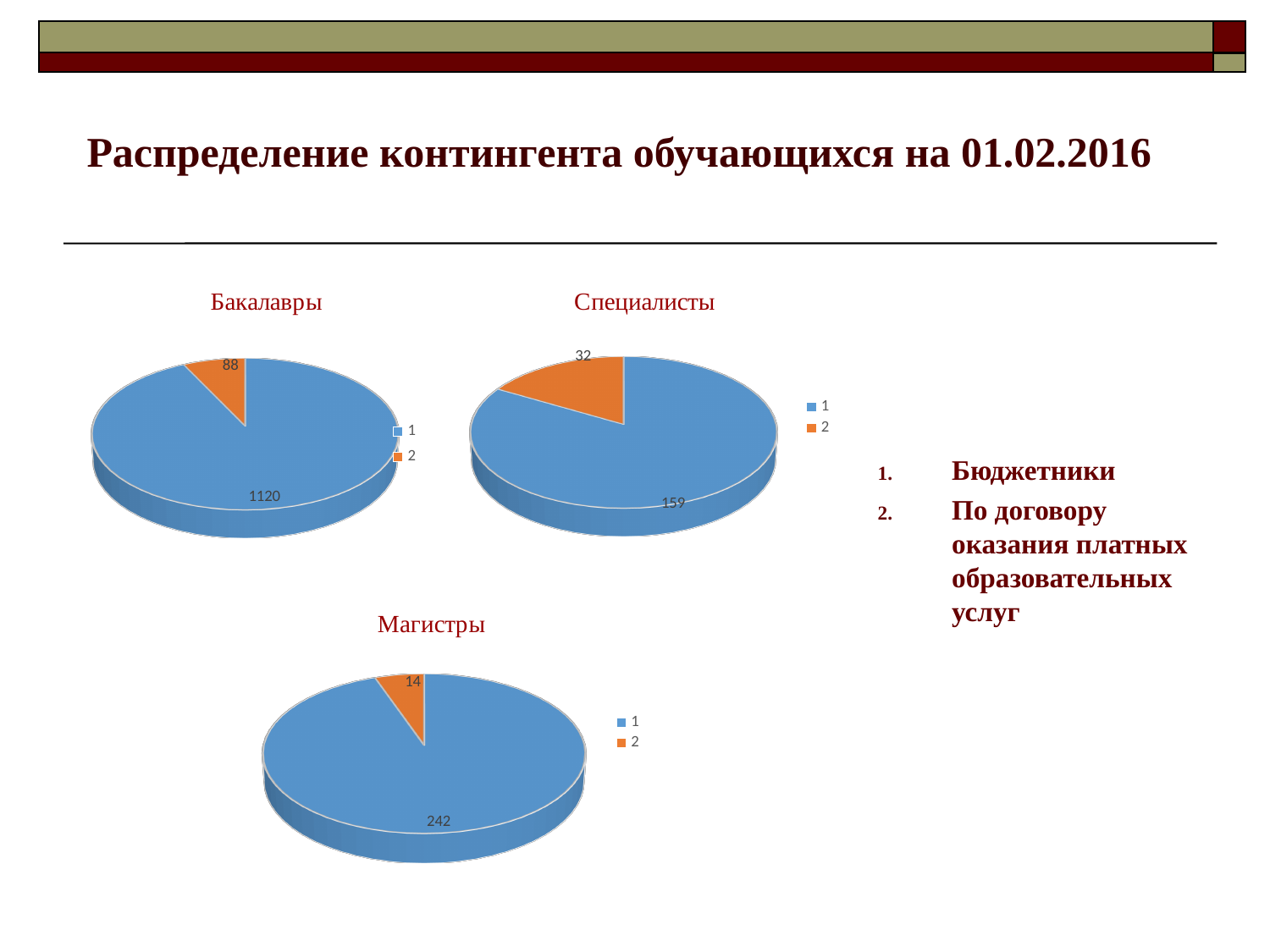
Is slice 2 in the Специалисты pie chart larger or smaller than slice 2 in the Магистры pie chart? larger In the Магистры pie chart, what is the value of slice 1? 242 In the Специалисты pie chart, what is the value of slice 2? 32 In the Специалисты pie chart, which slice is the largest? 1 In the Специалисты pie chart, what is the total of the two slices? 191 What type of chart is used for Магистры? Pie chart In the Бакалавры pie chart, what is the difference between slice 1 and slice 2? 1032 How many slices does the Бакалавры pie chart have? 2 In the Магистры pie chart, which slice is the smallest? 2 In the Магистры pie chart, what is the total of the two slices? 256 In the Бакалавры pie chart, what is the value of slice 2? 88 In the Бакалавры pie chart, what is the value of slice 1? 1120